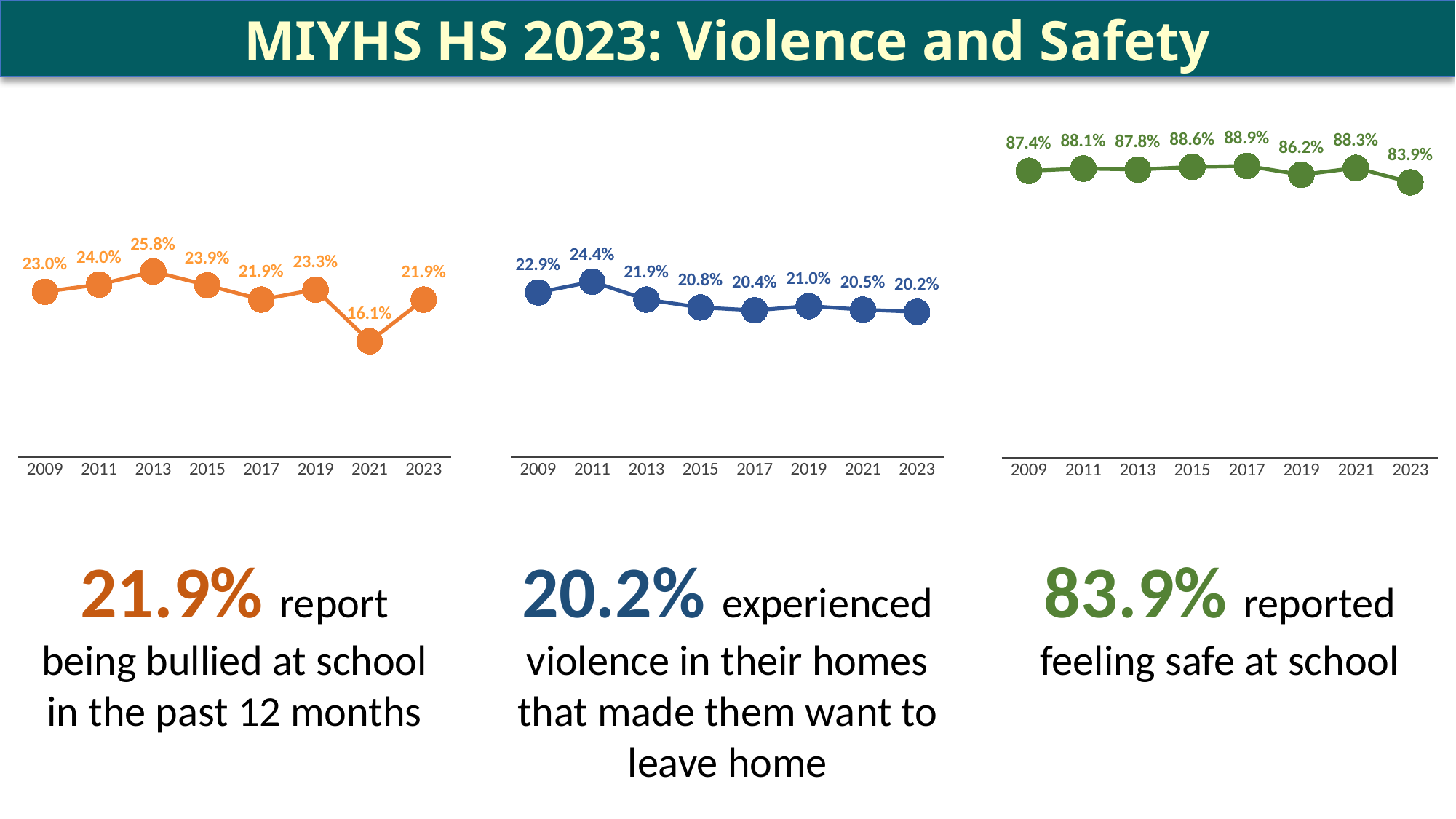
In the right chart (feeling safe at school), what is the value for 2017? 88.9% In the middle chart (violence in their homes), is the value for 2009 or 2023 larger? 2009 In the middle chart (violence in their homes), what is the value for 2011? 24.4% In the left chart (bullied at school), which year has the lowest value? 2021 In the middle chart (violence in their homes), do the values generally rise or fall from 2011 to 2023? Fall In the left chart (bullied at school), what is the value for 2013? 25.8% In the middle chart (violence in their homes), which year has the highest value? 2011 In the right chart (feeling safe at school), what is the difference between the 2021 value and the 2023 value? 4.4 percentage points How many data points are plotted in the left chart (bullied at school)? 8 What kind of chart is the middle chart (violence in their homes)? Line chart In the right chart (feeling safe at school), which year has the lowest value? 2023 In the left chart (bullied at school), what is the difference between the 2013 value and the 2021 value? 9.7 percentage points